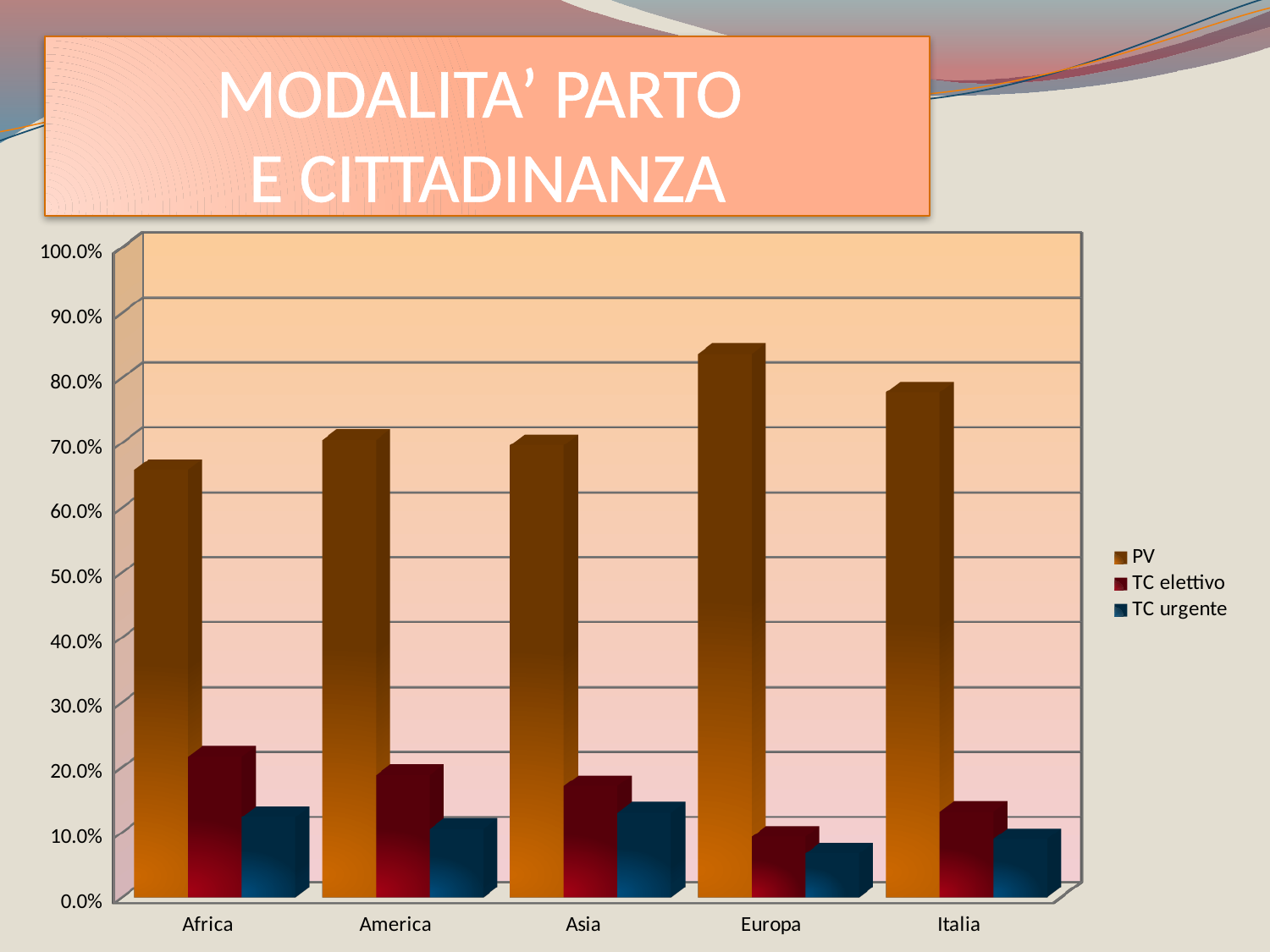
How many categories are shown on the x axis? 5 Which category has the lowest PV value? Africa Which is larger, the PV value for Europa or the PV value for Italia? Europa How many series does the legend list? 3 Which category has the lowest TC elettivo value? Europa Which category has the highest PV value? Europa Which category has the highest TC elettivo value? Africa What kind of chart is shown on the slide? bar chart Is the TC urgente value for Europa greater or less than 10.0%? less What is the title of the slide containing the chart? MODALITA' PARTO E CITTADINANZA Is the PV value for Europa greater or less than 80.0%? greater Is the PV value for Africa greater or less than 70.0%? less